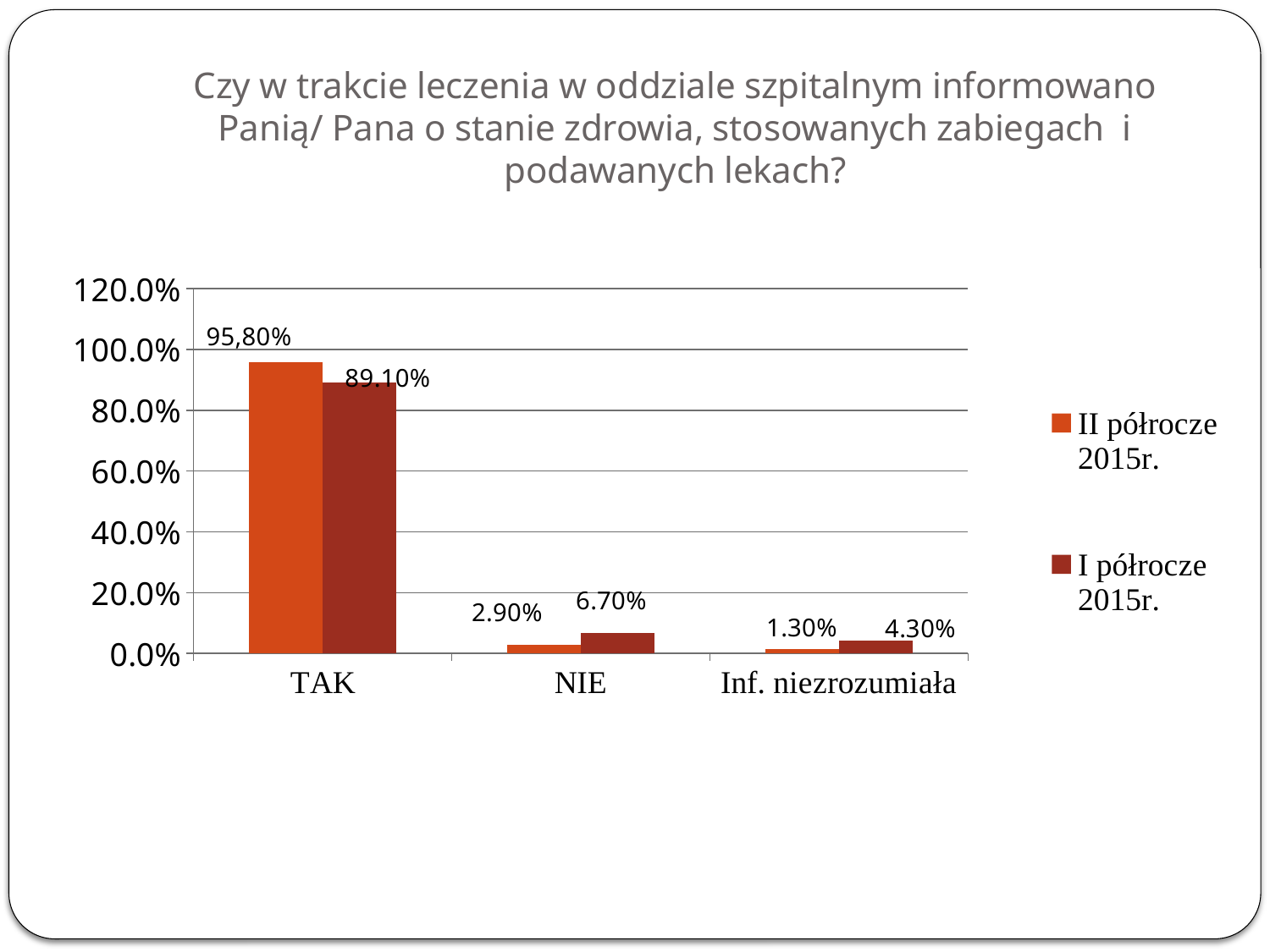
What is the difference between the I półrocze 2015r. and II półrocze 2015r. values for NIE? 3.80% How many categories are shown on the x axis? 3 What type of chart is shown on the slide? bar chart Which category has the highest value in the II półrocze 2015r. series? TAK What is the value for NIE in the I półrocze 2015r. series? 6.70% How many series does the legend list? 2 What is the value for TAK in the II półrocze 2015r. series? 95,80% What is the value for TAK in the I półrocze 2015r. series? 89.10% What is the value for Inf. niezrozumiała in the II półrocze 2015r. series? 1.30% Which category has the lowest value in the I półrocze 2015r. series? Inf. niezrozumiała For Inf. niezrozumiała, which series has the larger value, I półrocze 2015r. or II półrocze 2015r.? I półrocze 2015r. Which series is shown in orange in the legend? II półrocze 2015r.